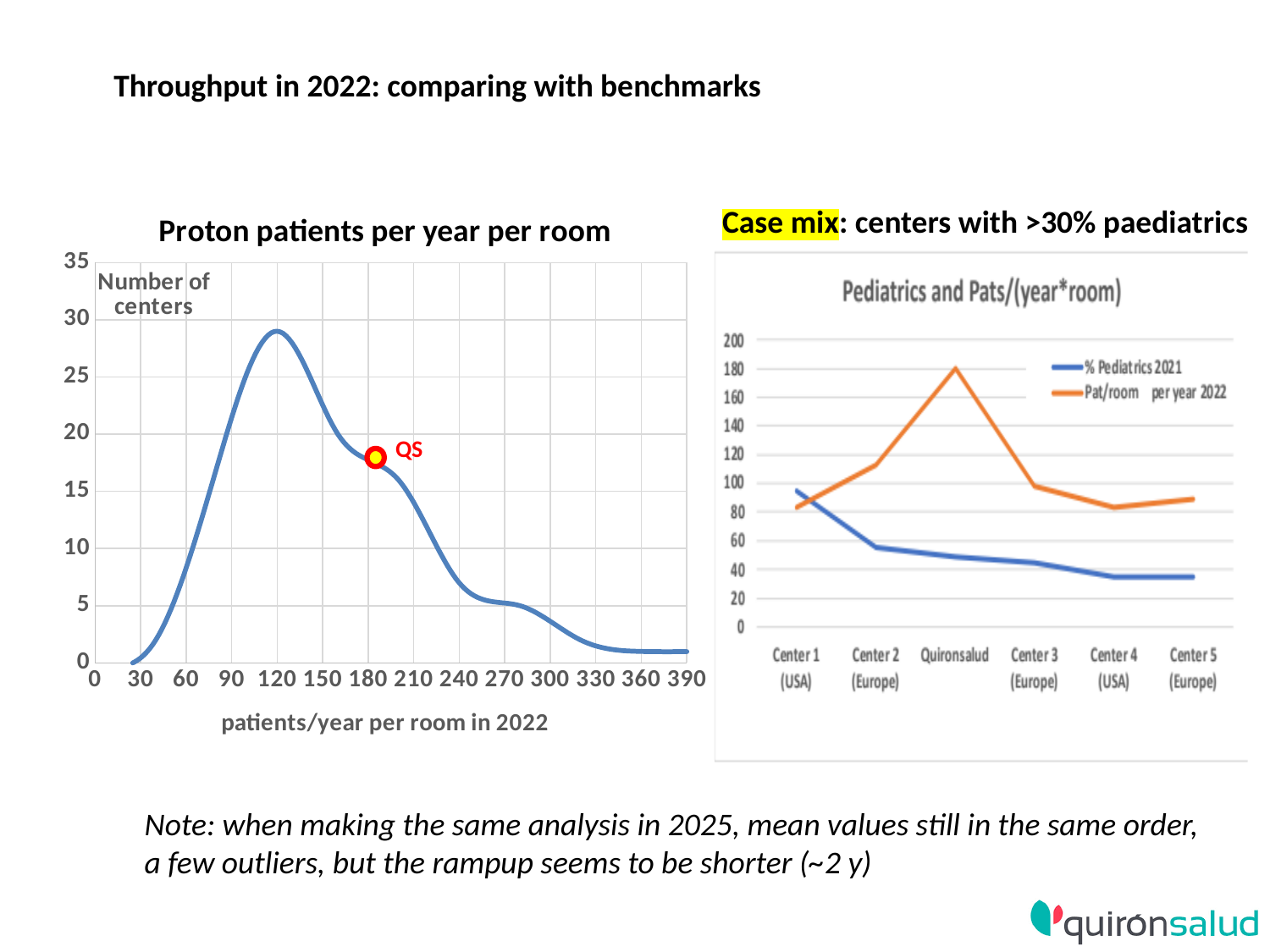
What is the x-axis title of the left chart "Proton patients per year per room"? patients/year per room in 2022 In the right chart "Pediatrics and Pats/(year*room)", which center has the highest Pat/room per year 2022 value? Quironsalud In the right chart "Pediatrics and Pats/(year*room)", which series has the larger value at Quironsalud, % Pediatrics 2021 or Pat/room per year 2022? Pat/room per year 2022 In the right chart "Pediatrics and Pats/(year*room)", which center has the highest % Pediatrics 2021 value? Center 1 (USA) How many series does the legend of the right chart "Pediatrics and Pats/(year*room)" list? 2 In the left chart "Proton patients per year per room", is the peak number of centers greater or less than 25? greater In the left chart "Proton patients per year per room", is the value at the point marked QS greater or less than 15? greater In the right chart "Pediatrics and Pats/(year*room)", is the Pat/room per year 2022 value for Quironsalud greater or less than 160? greater In the left chart "Proton patients per year per room", does the number of centers rise or fall between 120 and 240 patients/year per room? fall How many centers are shown on the x axis of the right chart "Pediatrics and Pats/(year*room)"? 6 What type of chart is the left chart titled "Proton patients per year per room"? line chart